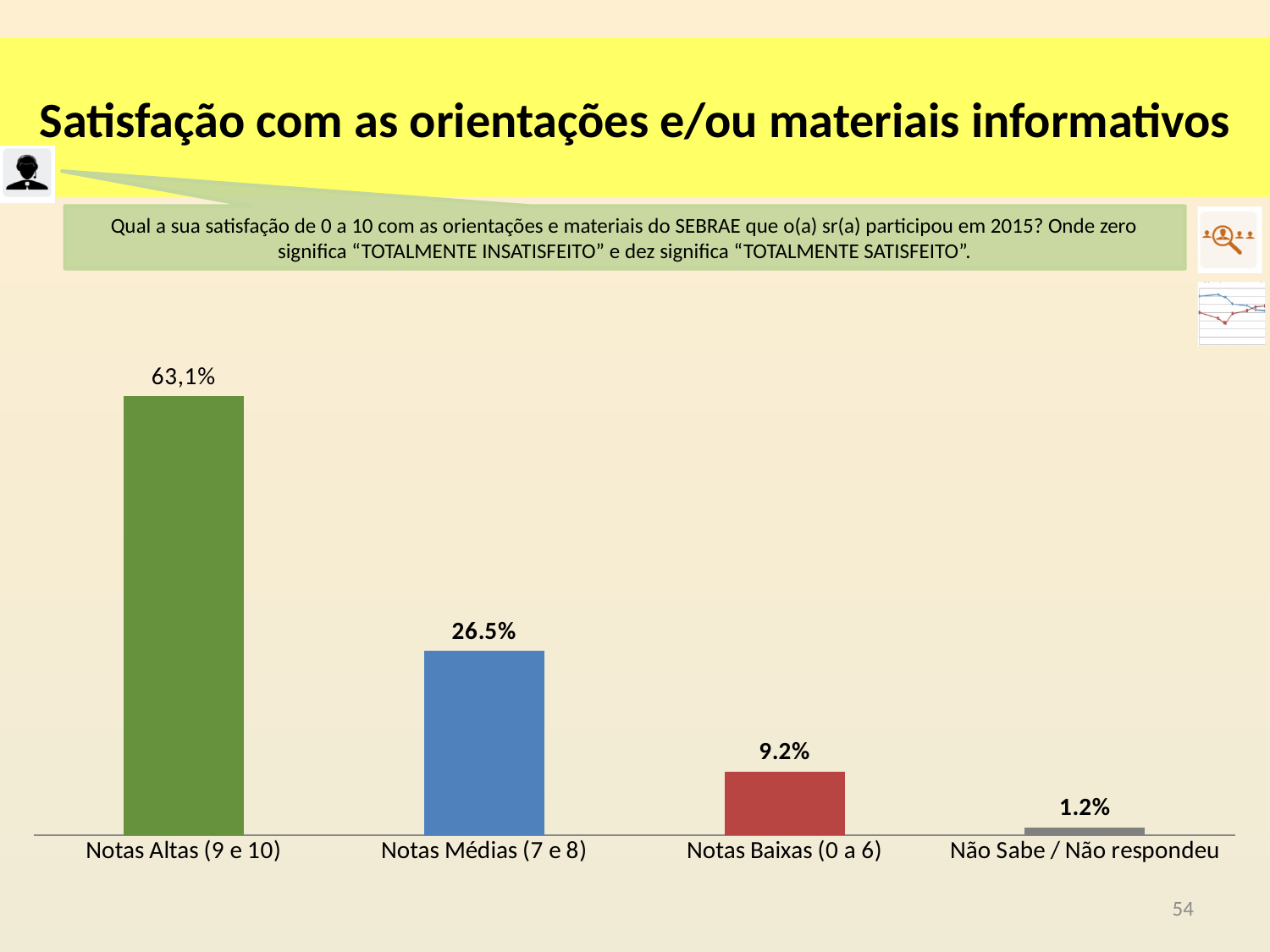
Which category has the lowest value? Não Sabe / Não respondeu What is the difference between the values for Notas Médias (7 e 8) and Notas Baixas (0 a 6)? 17.3% Which category has the highest value? Notas Altas (9 e 10) What is the value for Notas Altas (9 e 10)? 63,1% What kind of chart is shown on the slide? Bar chart What is the value for Notas Baixas (0 a 6)? 9.2% What is the value for Não Sabe / Não respondeu? 1.2% Do the values rise or fall from left to right along the x axis? Fall What colour is the bar for Notas Baixas (0 a 6)? Red What is the value for Notas Médias (7 e 8)? 26.5% Which is larger, the value for Notas Médias (7 e 8) or the value for Notas Baixas (0 a 6)? Notas Médias (7 e 8) How many categories are shown in the chart? 4